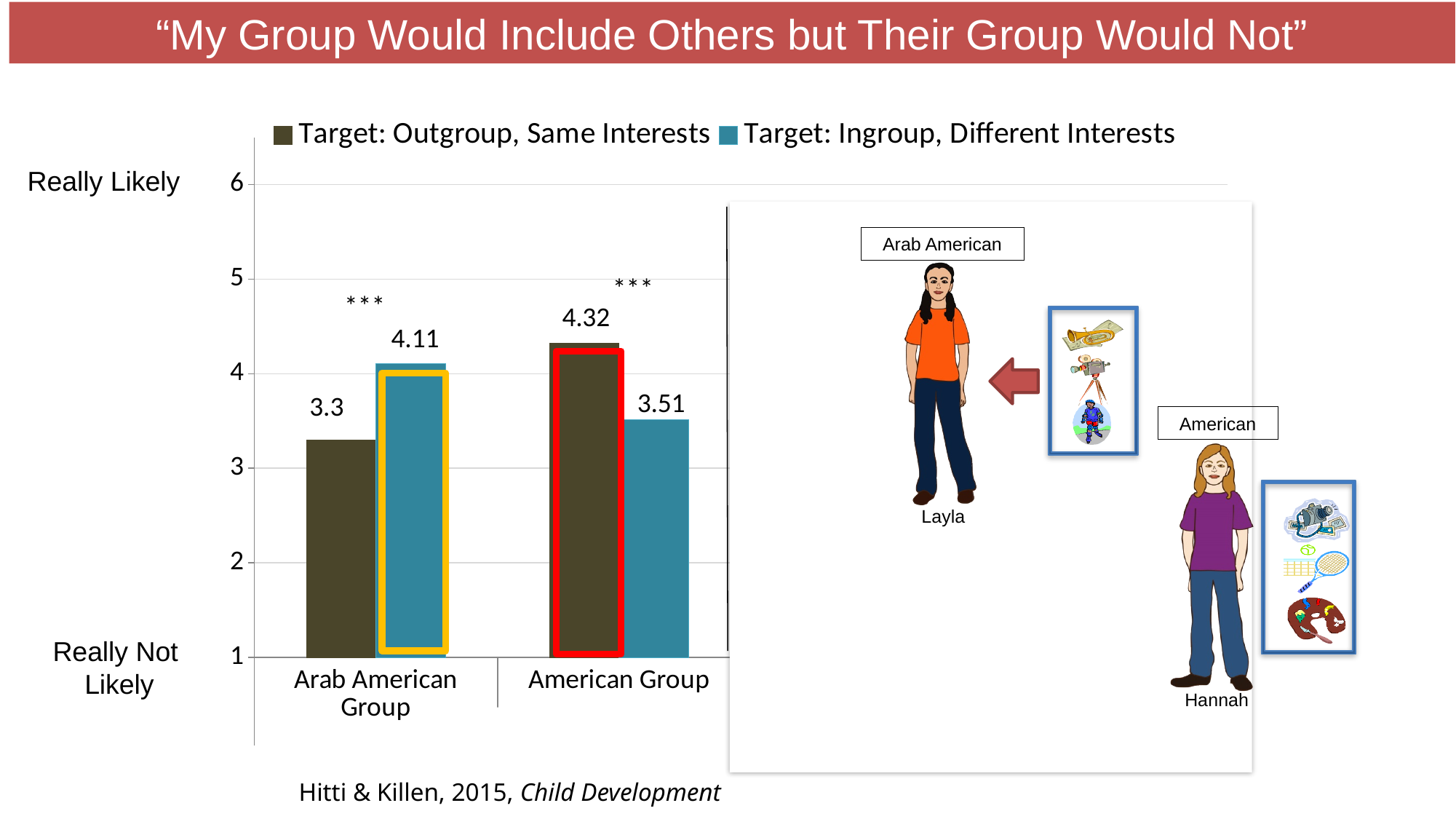
What is the value for Target: Outgroup, Same Interests in the Arab American Group? 3.3 How many series does the legend list? 2 What is the value for Target: Ingroup, Different Interests in the Arab American Group? 4.11 What is the value for Target: Ingroup, Different Interests in the American Group? 3.51 Is the value for Target: Outgroup, Same Interests in the Arab American Group greater or less than 4? less What kind of chart is shown on the slide? bar chart What is the difference between the two series' values in the Arab American Group? 0.81 What is the value for Target: Outgroup, Same Interests in the American Group? 4.32 Which series has the higher value in the Arab American Group? Target: Ingroup, Different Interests What label appears at the top of the y axis, next to the value 6? Really Likely What is the difference between the two series' values in the American Group? 0.81 Which series has the higher value in the American Group? Target: Outgroup, Same Interests